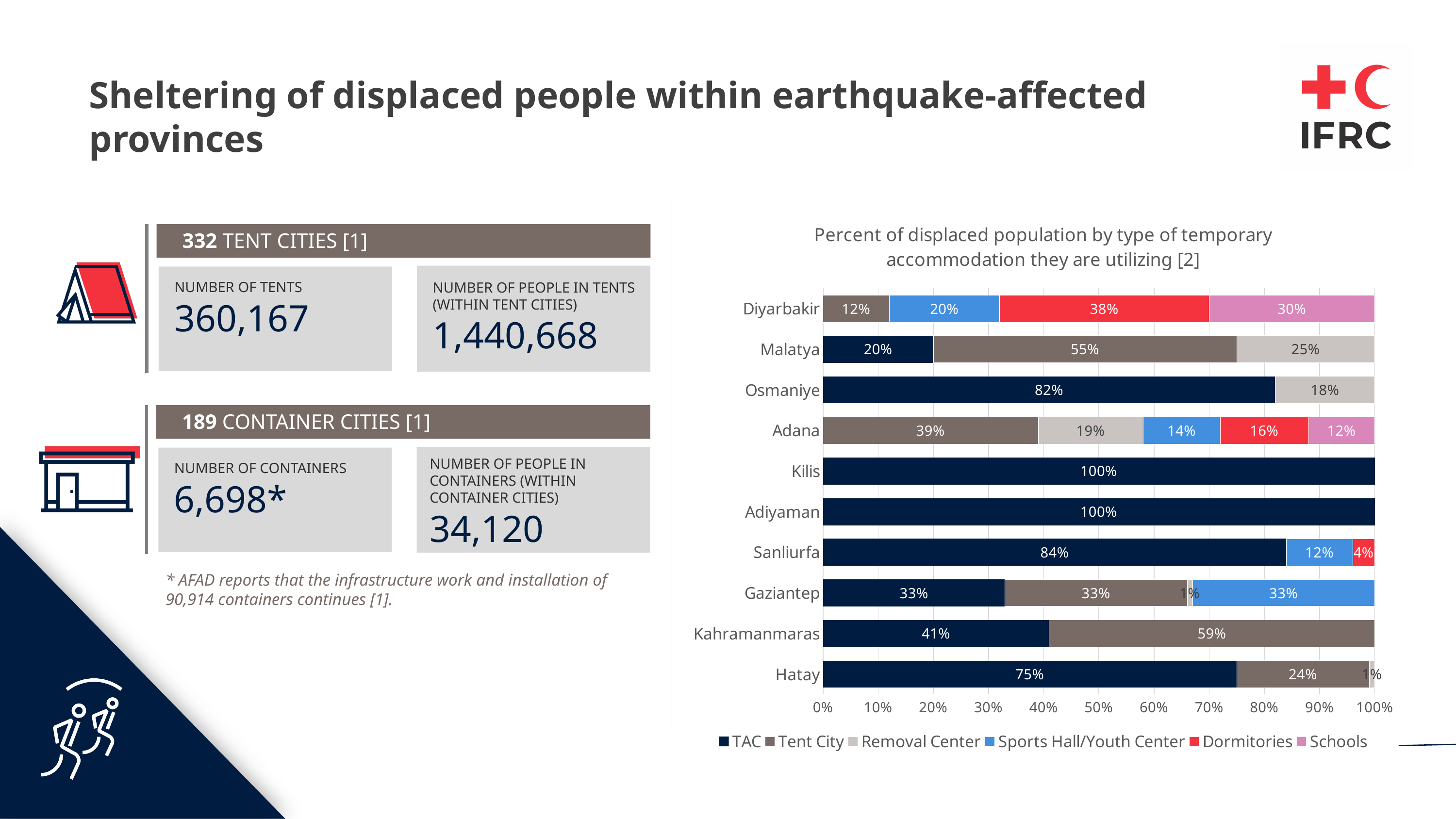
How many series does the chart legend list? 6 Which provinces have 100% of their displaced population in TAC? Kilis and Adiyaman What kind of chart is shown on the slide? stacked bar chart What percentage of the displaced population in Kahramanmaras is in Tent City? 59% What percentage of the displaced population in Osmaniye is in TAC? 82% What percentage of the displaced population in Diyarbakir is in Dormitories? 38% Which province has the lowest TAC share among those with a TAC segment shown? Malatya How many provinces are listed on the chart? 10 Which is larger: the TAC share in Sanliurfa or the TAC share in Hatay? Sanliurfa What is the title of the chart? Percent of displaced population by type of temporary accommodation they are utilizing [2] What is the difference between the Tent City share in Malatya and the Tent City share in Hatay? 31% What percentage of the displaced population in Adana is in Sports Hall/Youth Center? 14%